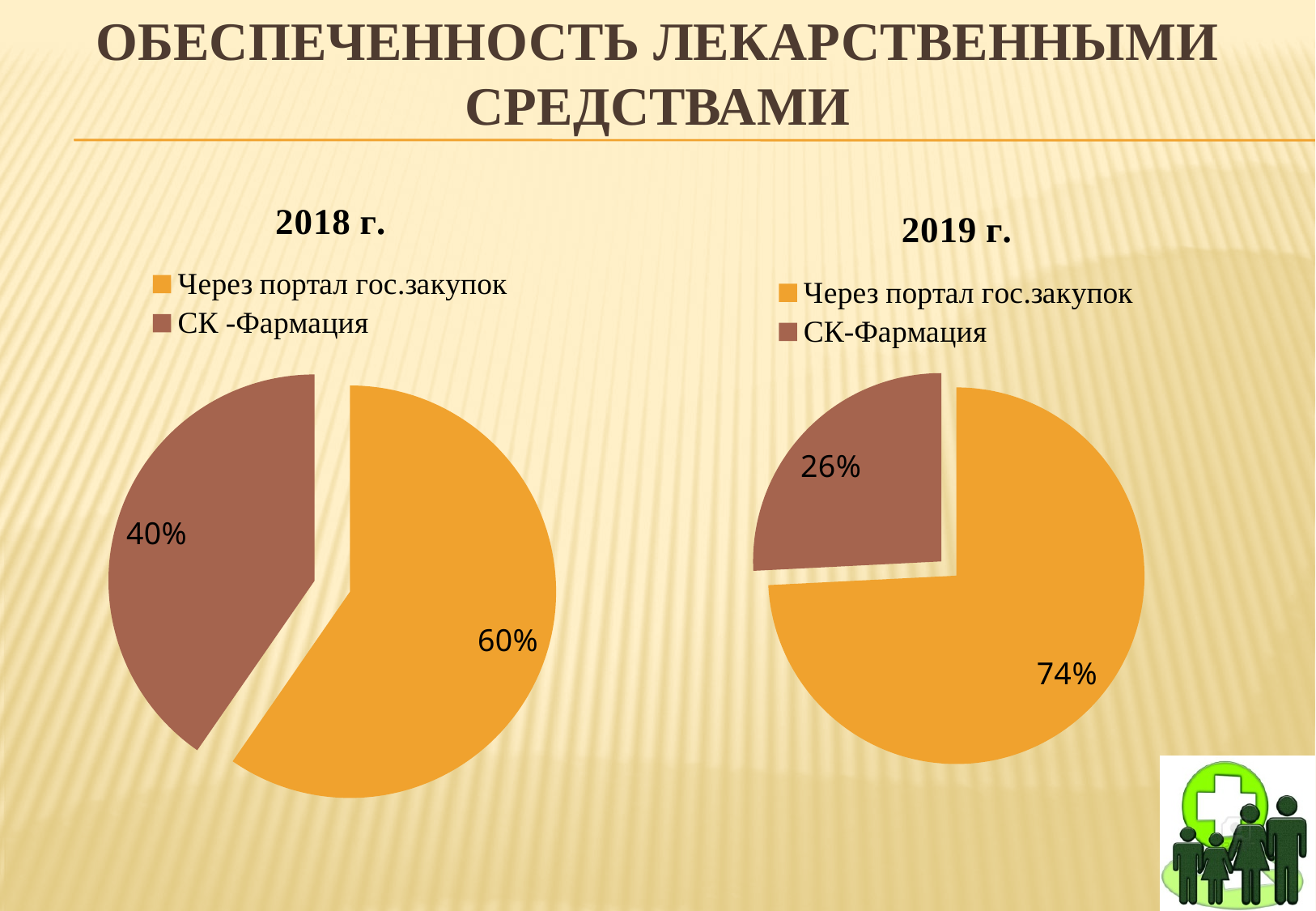
In the 2018 г. chart, what is the difference between the Через портал гос.закупок share and the СК -Фармация share? 20% Which is larger: the Через портал гос.закупок share in the 2018 г. chart or in the 2019 г. chart? 2019 г. In the 2019 г. chart, which category has the smallest slice? СК-Фармация How many categories does the legend of the 2019 г. chart list? 2 What is the title of the slide containing the two pie charts? ОБЕСПЕЧЕННОСТЬ ЛЕКАРСТВЕННЫМИ СРЕДСТВАМИ What type of chart is the 2018 г. chart? Pie chart In the 2018 г. pie chart, what share does Через портал гос.закупок have? 60% In the 2019 г. pie chart, what share does Через портал гос.закупок have? 74% In the 2018 г. chart, which category has the largest slice? Через портал гос.закупок In the 2019 г. chart, what is the difference between the Через портал гос.закупок share and the СК-Фармация share? 48% In the 2018 г. pie chart, what share does СК -Фармация have? 40% In the 2019 г. pie chart, what share does СК-Фармация have? 26%